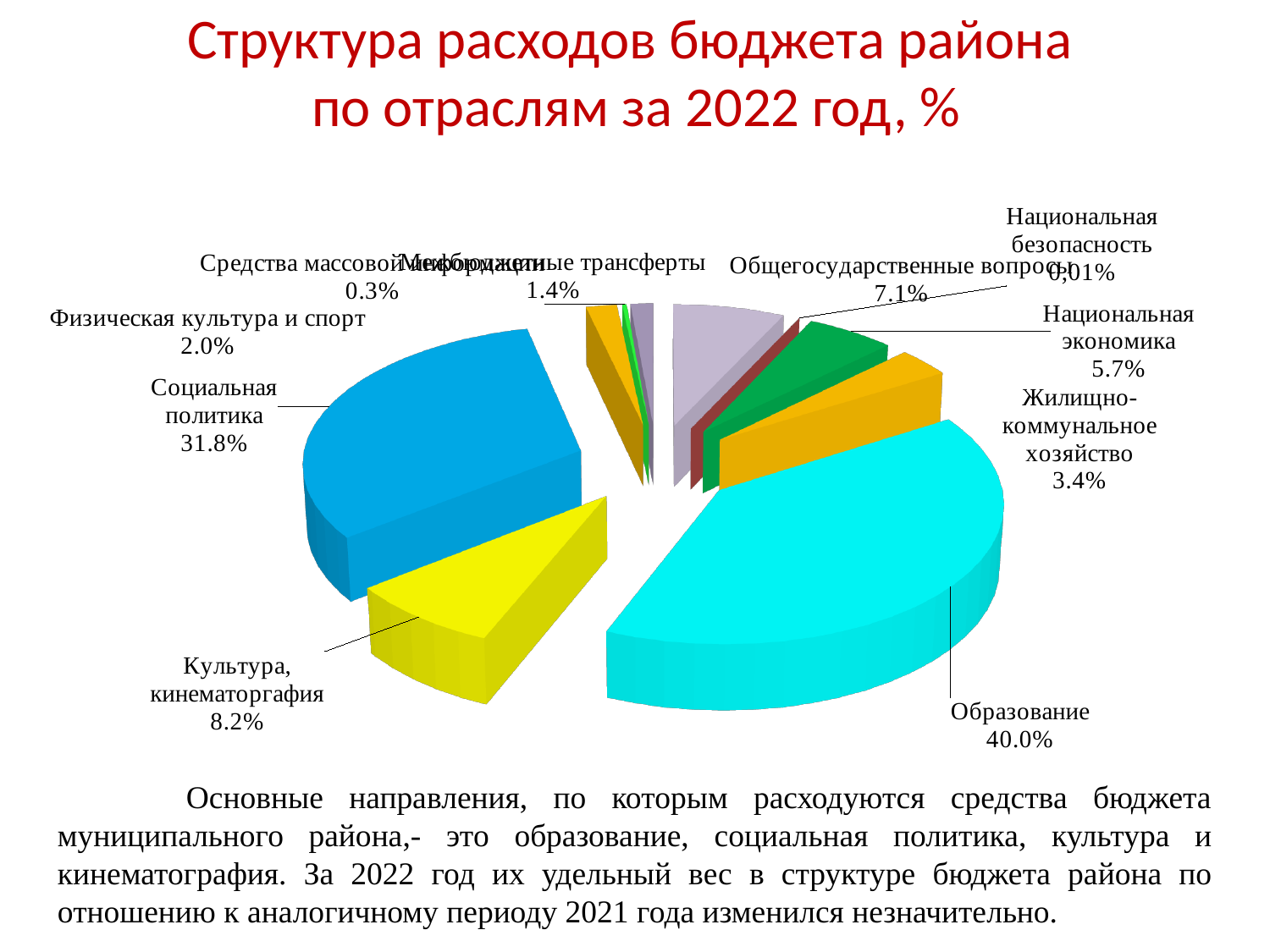
What share of expenditures goes to Социальная политика? 31.8% Which is larger: the share for Национальная экономика or the share for Жилищно-коммунальное хозяйство? Национальная экономика Which category has the smallest share of the district budget expenditures? Национальная безопасность What is the difference in percentage points between Образование and Социальная политика? 8.2 What share of expenditures goes to Физическая культура и спорт? 2.0% What share of expenditures goes to Жилищно-коммунальное хозяйство? 3.4% Which category has the largest share of the district budget expenditures? Образование What share of expenditures goes to Культура, кинематоргафия? 8.2% What share of expenditures goes to Образование? 40.0% What is the title of the chart? Структура расходов бюджета района по отраслям за 2022 год, % What kind of chart is shown on the slide? pie chart What share of expenditures goes to Общегосударственные вопросы? 7.1%